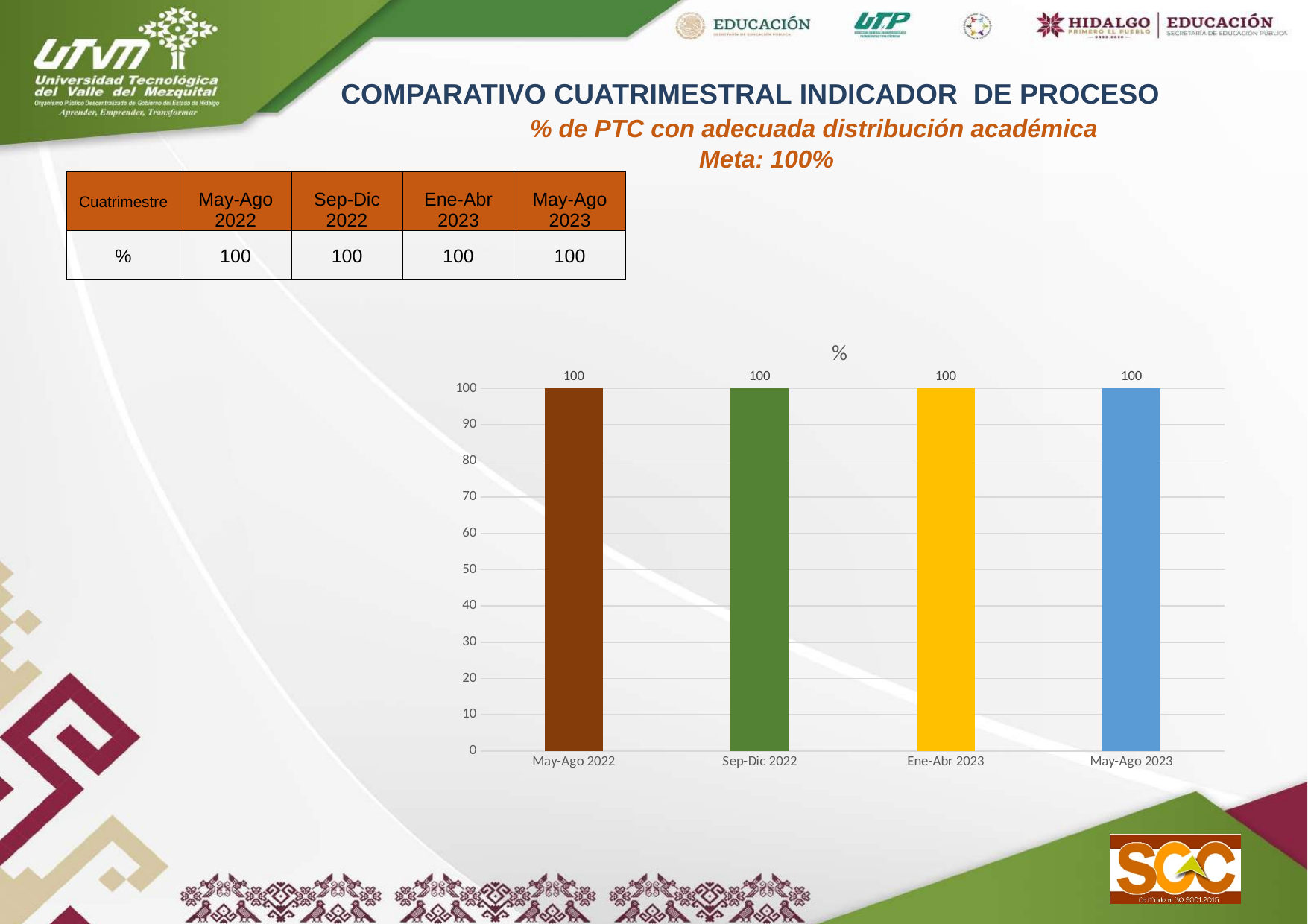
What is the value for Ene-Abr 2023 in the chart? 100 What is the value for May-Ago 2022 in the chart? 100 What is the difference between the values for May-Ago 2022 and May-Ago 2023? 0 Is the value for Ene-Abr 2023 greater or less than 50? greater What is the highest value shown on the y axis of the chart? 100 What is the value for Sep-Dic 2022 in the chart? 100 What is the value for May-Ago 2023 in the chart? 100 What colour is the bar for Sep-Dic 2022? green Do the values rise, fall, or stay the same from May-Ago 2022 to May-Ago 2023? stay the same How many categories are shown on the x axis of the chart? 4 What kind of chart is shown on the slide? bar chart What is the title of the chart? %